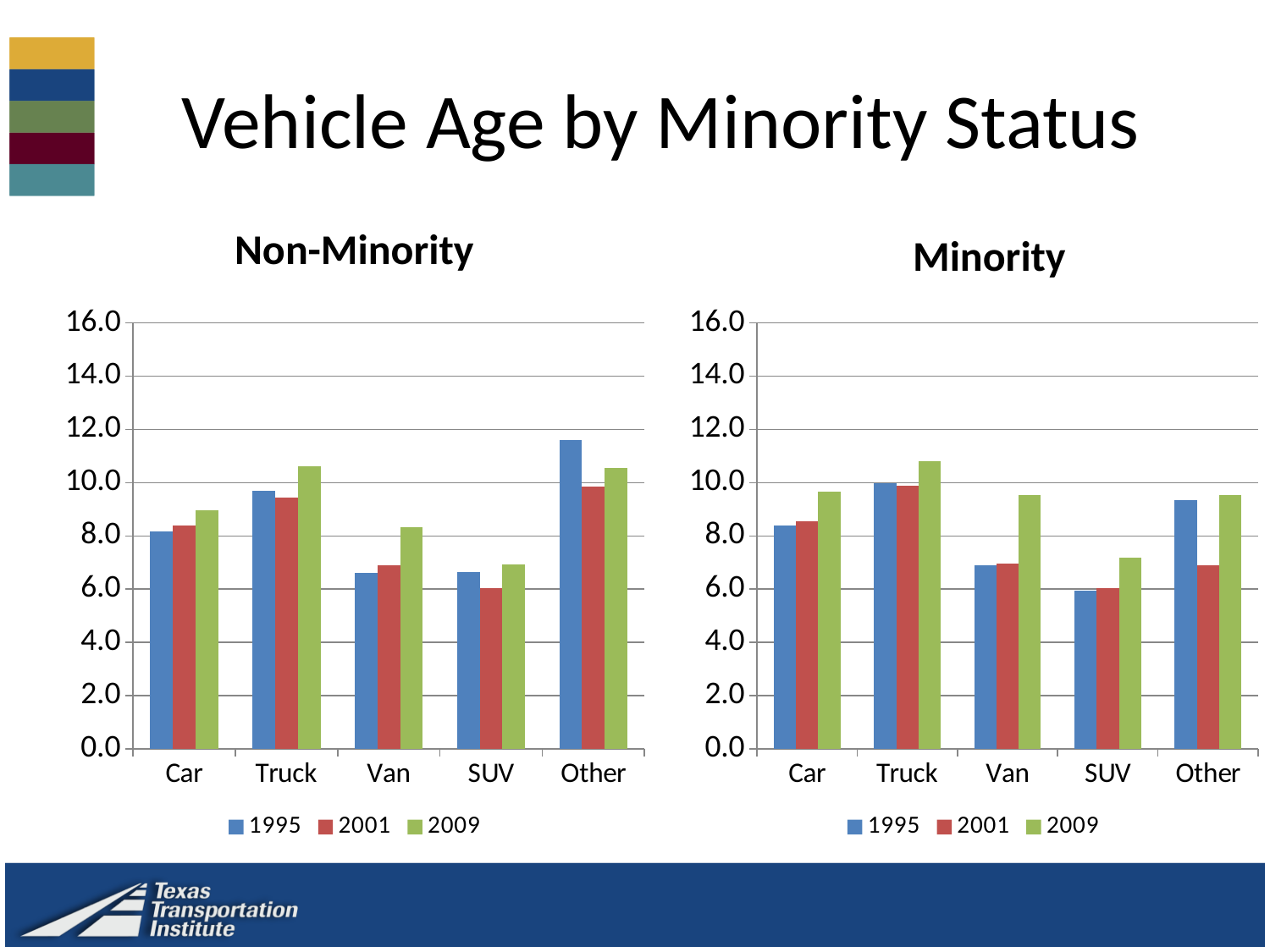
What are the three series listed in the legend of the Minority chart? 1995, 2001, 2009 In the Minority chart, do the values for Car rise or fall from 1995 to 2009? rise In the Non-Minority chart, which vehicle category has the highest 1995 value? Other How many vehicle categories are shown on the x axis of the Minority chart? 5 In the Minority chart, is the 2009 value for Truck greater or less than 10.0? greater In the Minority chart, which is larger for Other: the 1995 value or the 2001 value? 1995 In the Non-Minority chart, is the 1995 value for Other greater or less than 10.0? greater What kind of chart is the Non-Minority chart? bar chart How many series does the legend of the Non-Minority chart list? 3 In the Non-Minority chart, which vehicle category has the lowest 2009 value? SUV In the Minority chart, which vehicle category has the highest 2009 value? Truck In the Non-Minority chart, is the 2001 value for SUV greater or less than 8.0? less